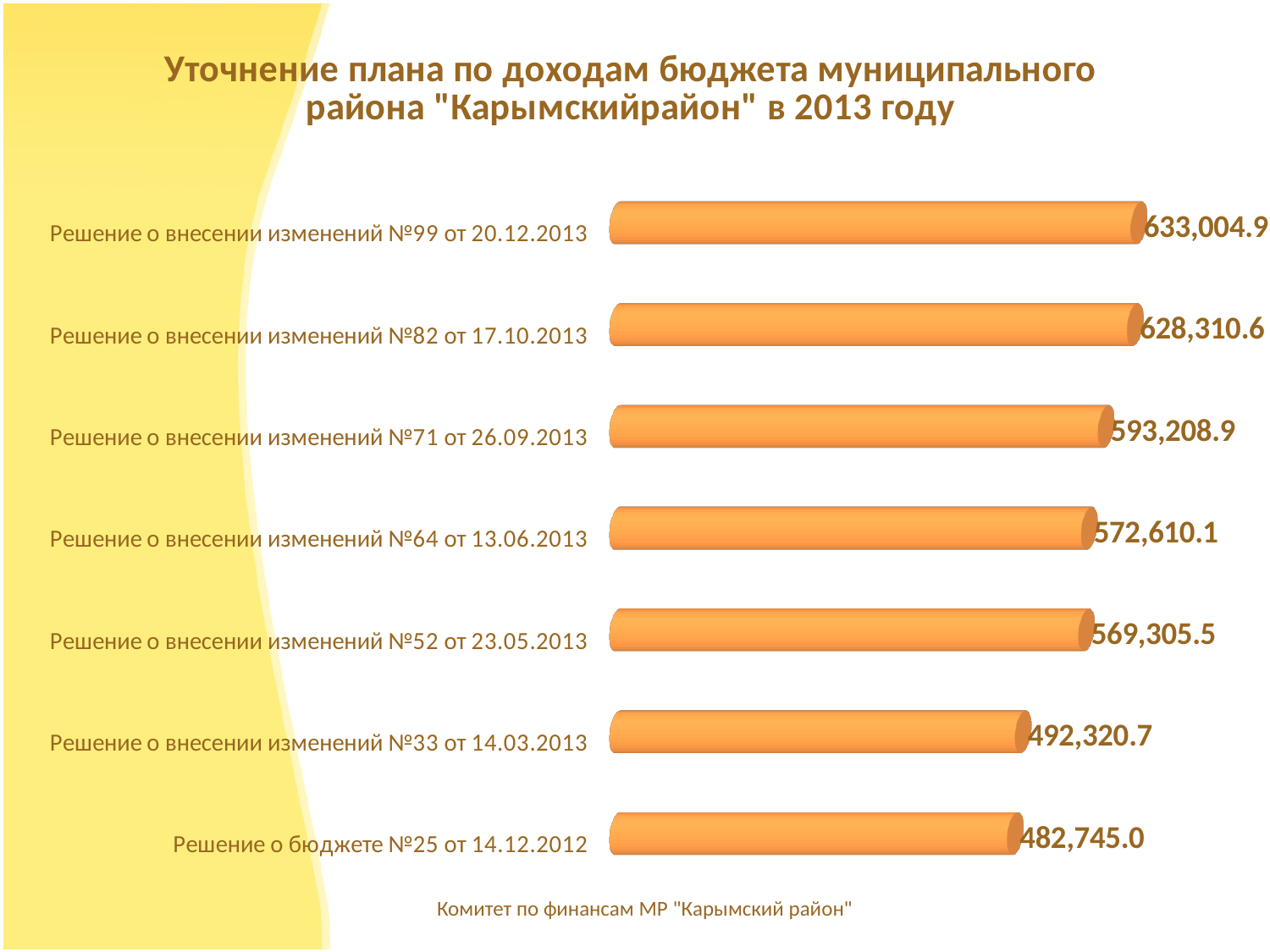
What is the difference between the values for "Решение о внесении изменений №71 от 26.09.2013" and "Решение о внесении изменений №64 от 13.06.2013"? 20,598.8 What is the difference between the values for "Решение о внесении изменений №99 от 20.12.2013" and "Решение о бюджете №25 от 14.12.2012"? 150,259.9 Which category has the highest value? Решение о внесении изменений №99 от 20.12.2013 Which is larger: the value for "Решение о внесении изменений №82 от 17.10.2013" or for "Решение о внесении изменений №71 от 26.09.2013"? Решение о внесении изменений №82 от 17.10.2013 What is the value for "Решение о бюджете №25 от 14.12.2012"? 482,745.0 What is the value for "Решение о внесении изменений №64 от 13.06.2013"? 572,610.1 What is the title of the chart on the slide? Уточнение плана по доходам бюджета муниципального района "Карымскийрайон" в 2013 году Do the values increase or decrease from the earliest decision at the bottom of the chart to the latest decision at the top? increase Which category has the lowest value? Решение о бюджете №25 от 14.12.2012 How many categories (decisions) are plotted in the chart? 7 What type of chart is shown on the slide? bar chart What is the value for "Решение о внесении изменений №99 от 20.12.2013"? 633,004.9